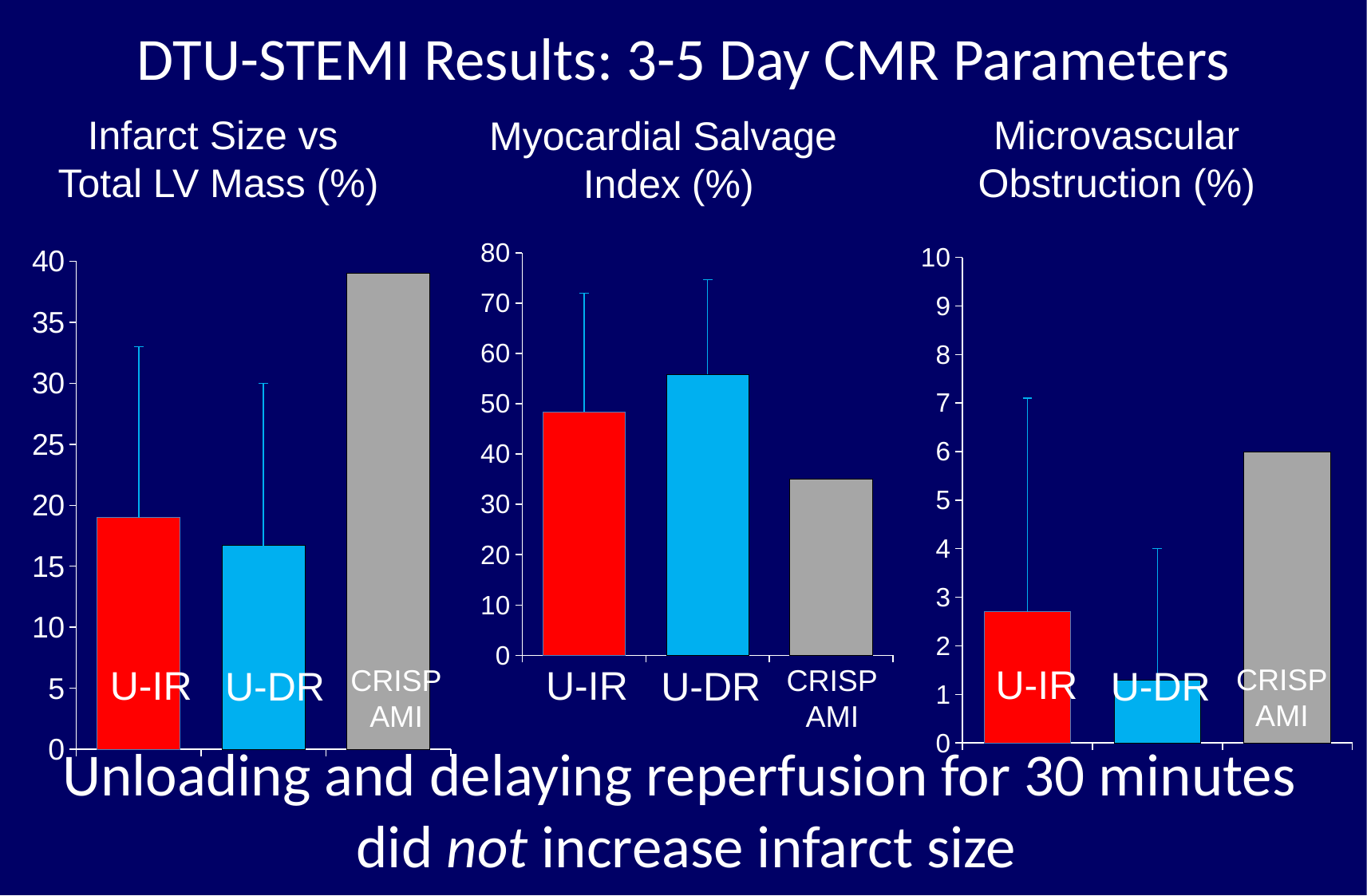
How many bars are in the 'Myocardial Salvage Index (%)' chart? 3 In the 'Myocardial Salvage Index (%)' chart, which category has the lowest bar? CRISP AMI In the 'Myocardial Salvage Index (%)' chart, which category has the highest bar? U-DR In the 'Myocardial Salvage Index (%)' chart, is the value for U-IR greater or less than 40? greater In the 'Myocardial Salvage Index (%)' chart, which is larger, U-DR or CRISP AMI? U-DR In the 'Infarct Size vs Total LV Mass (%)' chart, which category has the highest bar? CRISP AMI In the 'Microvascular Obstruction (%)' chart, which category has the lowest bar? U-DR In the 'Infarct Size vs Total LV Mass (%)' chart, is the value for CRISP AMI greater or less than 35? greater In the 'Infarct Size vs Total LV Mass (%)' chart, which category has the lowest bar? U-DR What kind of chart is the 'Infarct Size vs Total LV Mass (%)' chart? bar chart In the 'Microvascular Obstruction (%)' chart, is the value for U-IR greater or less than 4? less In the 'Microvascular Obstruction (%)' chart, which category has the highest bar? CRISP AMI